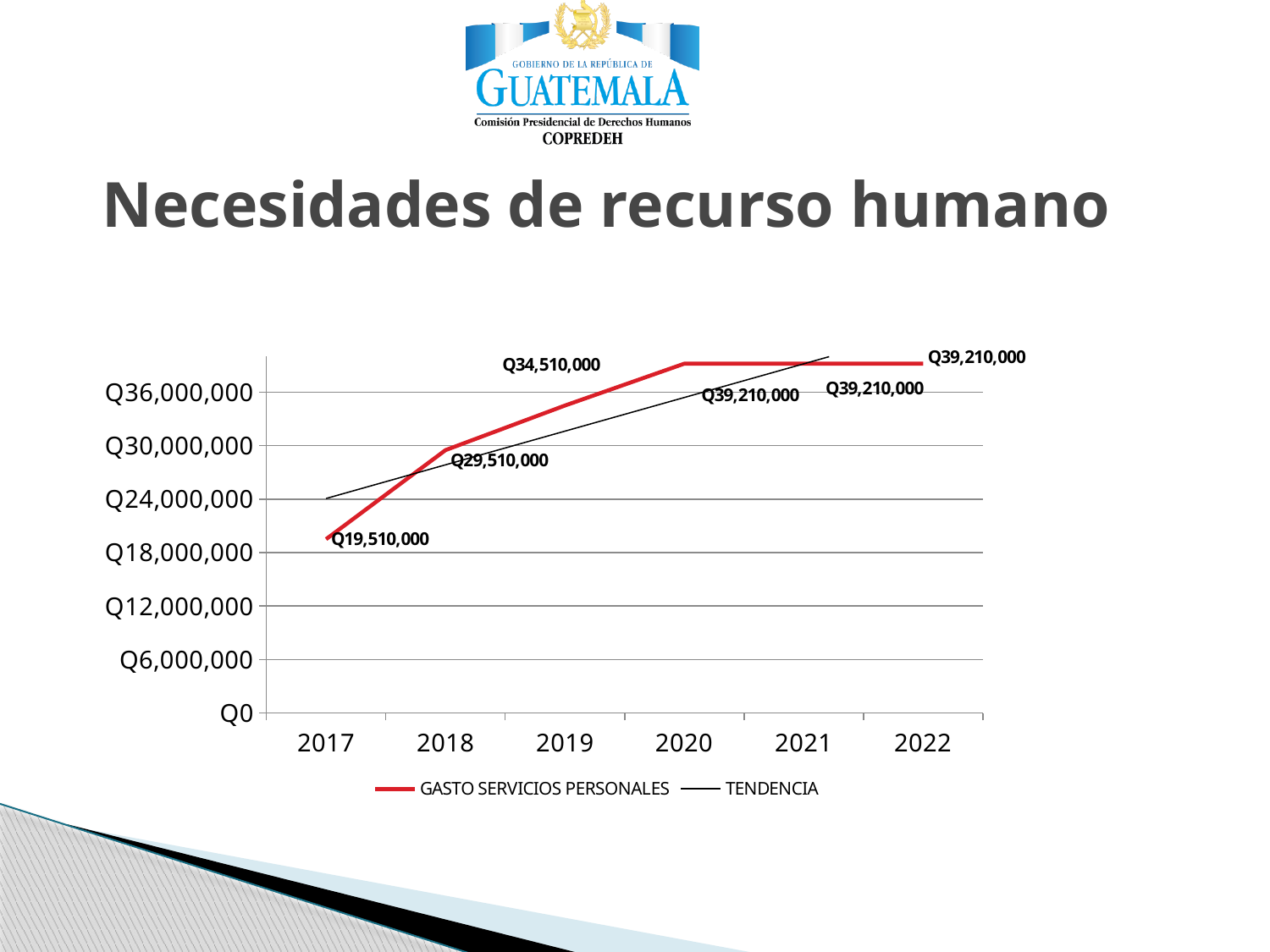
Is the GASTO SERVICIOS PERSONALES value for 2017 greater or less than Q24,000,000? less What is the difference between the GASTO SERVICIOS PERSONALES values for 2018 and 2017? Q10,000,000 What is the value for GASTO SERVICIOS PERSONALES in 2017? Q19,510,000 What kind of chart is shown on the slide? line chart Which is larger, the GASTO SERVICIOS PERSONALES value for 2019 or for 2018? 2019 Which year has the lowest value for GASTO SERVICIOS PERSONALES? 2017 What is the value for GASTO SERVICIOS PERSONALES in 2019? Q34,510,000 How many series does the legend list? 2 What is the value for GASTO SERVICIOS PERSONALES in 2018? Q29,510,000 How many years are shown on the x axis? 6 What is the difference between the GASTO SERVICIOS PERSONALES values for 2020 and 2019? Q4,700,000 What is the value for GASTO SERVICIOS PERSONALES in 2022? Q39,210,000